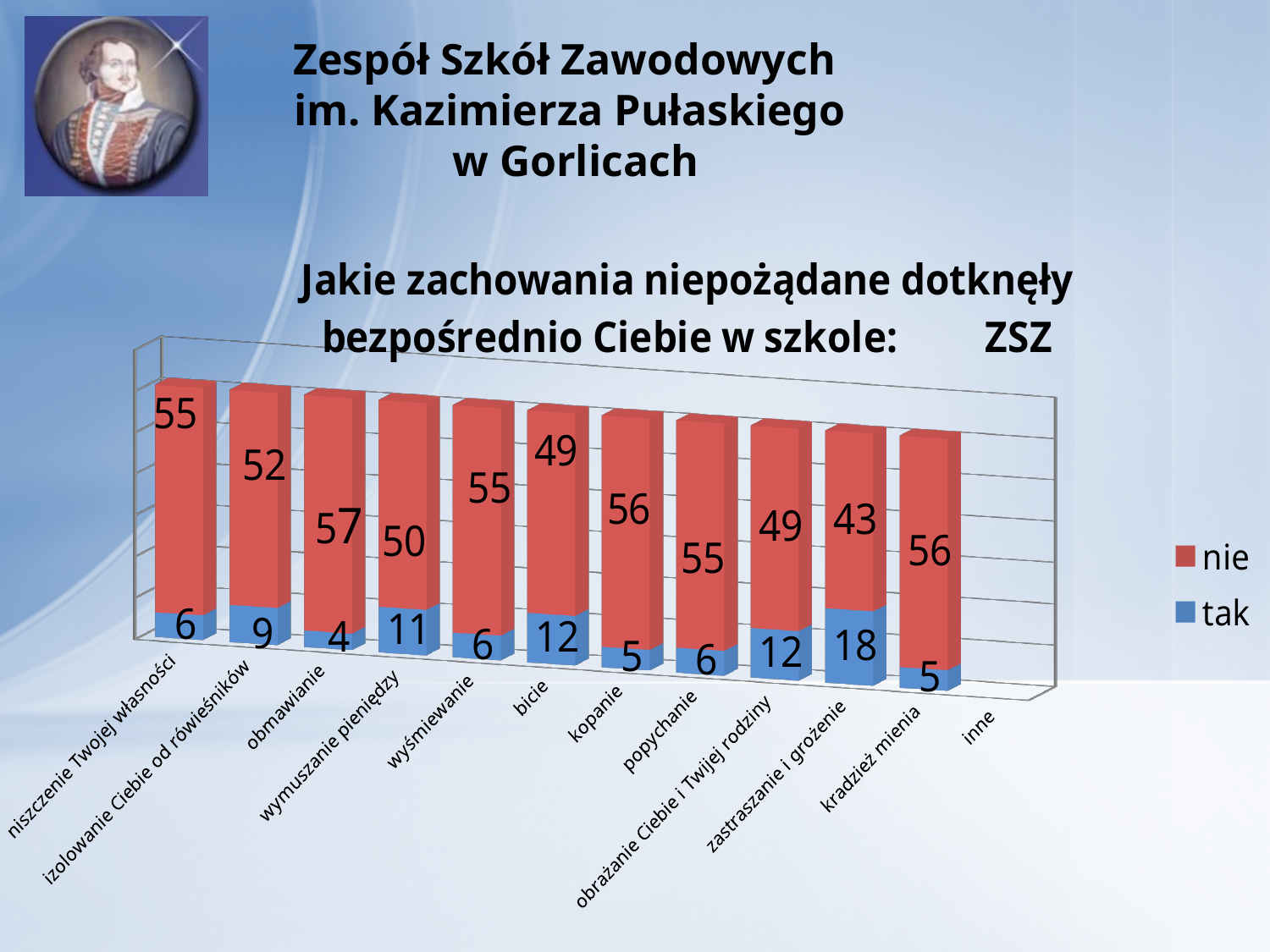
Which is larger: the "tak" value for "wymuszanie pieniędzy" or the "tak" value for "kopanie"? wymuszanie pieniędzy What is the value of the "nie" series for "wymuszanie pieniędzy"? 50 What is the difference between the "nie" and "tak" values for "zastraszanie i grożenie"? 25 Which category has the lowest "tak" value? obmawianie What is the value of the "nie" series for "obmawianie"? 57 What is the total of the stacked bar for "bicie"? 61 What kind of chart is shown on the slide? stacked bar chart What is the value of the "tak" series for "bicie"? 12 Which category has the highest "tak" value? zastraszanie i grożenie Which category has the lowest "nie" value? zastraszanie i grożenie What is the value of the "tak" series for "zastraszanie i grożenie"? 18 How many series does the legend list? 2